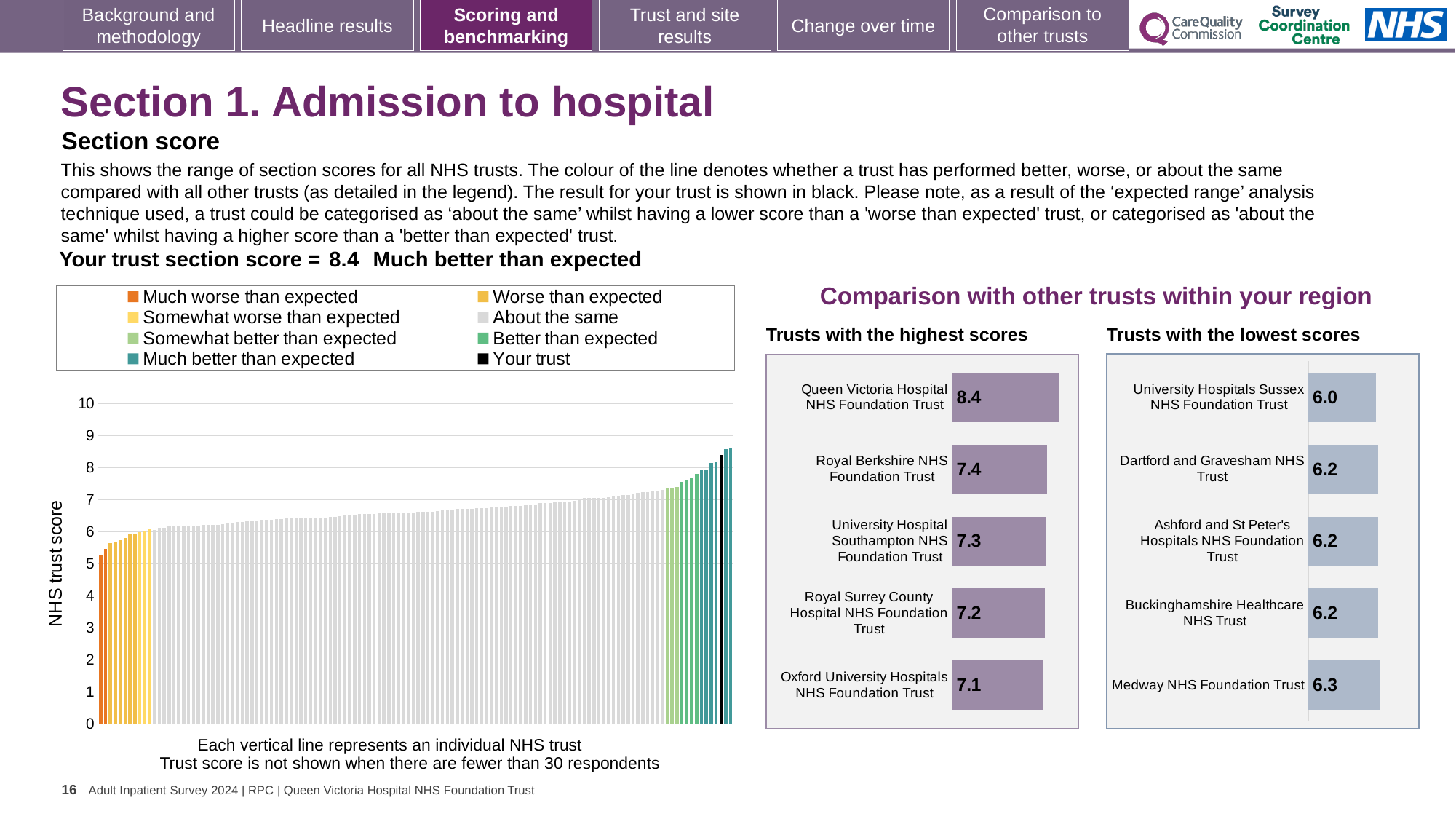
In the 'Trusts with the highest scores' chart, what is the score for Queen Victoria Hospital NHS Foundation Trust? 8.4 In the NHS trust score chart on the left, is the value of the black bar (your trust) greater or less than 8? greater How many trusts are shown in the 'Trusts with the lowest scores' chart? 5 How many entries does the legend of the NHS trust score chart on the left list? 8 In the 'Trusts with the lowest scores' chart, what is the score for University Hospitals Sussex NHS Foundation Trust? 6.0 In the 'Trusts with the lowest scores' chart, which has the higher score: University Hospitals Sussex NHS Foundation Trust or Medway NHS Foundation Trust? Medway NHS Foundation Trust In the 'Trusts with the highest scores' chart, which trust has the lowest score shown? Oxford University Hospitals NHS Foundation Trust What kind of chart is the NHS trust score chart on the left of the slide? Bar chart In the 'Trusts with the lowest scores' chart, what is the score for Medway NHS Foundation Trust? 6.3 In the 'Trusts with the highest scores' chart, what is the difference between the scores of Queen Victoria Hospital NHS Foundation Trust and Royal Berkshire NHS Foundation Trust? 1.0 In the NHS trust score chart on the left, do the values rise or fall from left to right? Rise In the 'Trusts with the highest scores' chart, what is the score for Royal Surrey County Hospital NHS Foundation Trust? 7.2